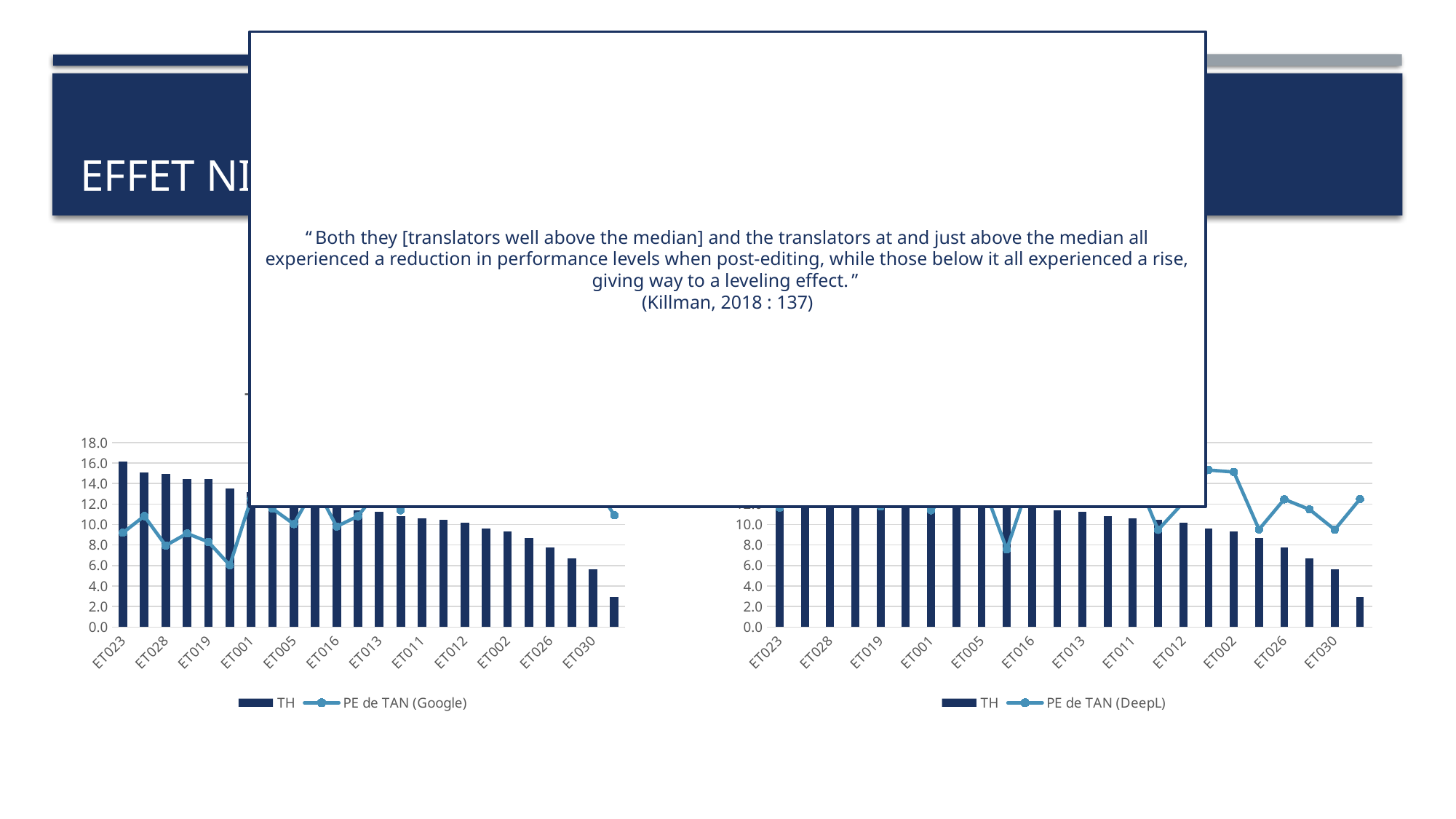
On the left chart, is the PE de TAN (Google) value for ET001 greater or less than 8.0? greater On the left chart, what is the name of the line series in the legend? PE de TAN (Google) On the right chart, what are the two legend entries? TH and PE de TAN (DeepL) On the left chart, what kind of chart is it? Combined bar and line chart On the left chart, is the TH value for ET023 greater or less than 14.0? greater On the left chart, which category has the highest TH bar? ET023 On the left chart, do the TH bars rise or fall from left to right along the x axis? fall On the left chart, is the TH value for ET030 greater or less than 8.0? less On the left chart, how many series does the legend list? 2 On the left chart, which is larger, the TH value for ET023 or the TH value for ET030? ET023